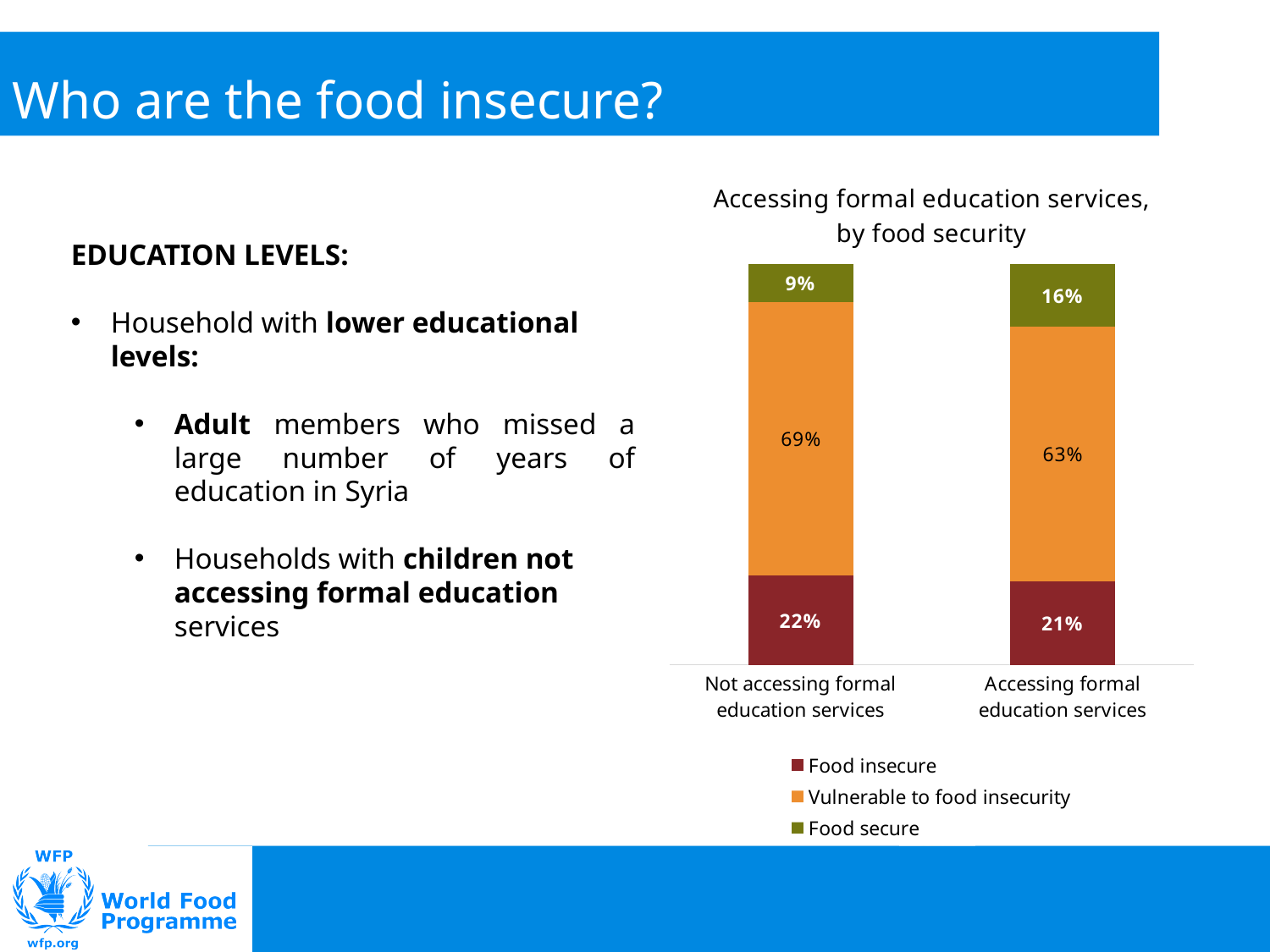
What is the difference in the Food secure share between Accessing formal education services and Not accessing formal education services? 7% Which category has the lowest Food secure value? Not accessing formal education services What is the Food secure value for Accessing formal education services? 16% What is the Food secure value for Not accessing formal education services? 9% Which category has the higher Vulnerable to food insecurity value? Not accessing formal education services What kind of chart is shown on the slide? Stacked bar chart What is the Food insecure value for Not accessing formal education services? 22% What is the Vulnerable to food insecurity value for Not accessing formal education services? 69% What is the total of the stacked bar for Accessing formal education services? 100% How many series does the legend list? 3 How many categories are shown on the x axis? 2 What is the title of the chart? Accessing formal education services, by food security